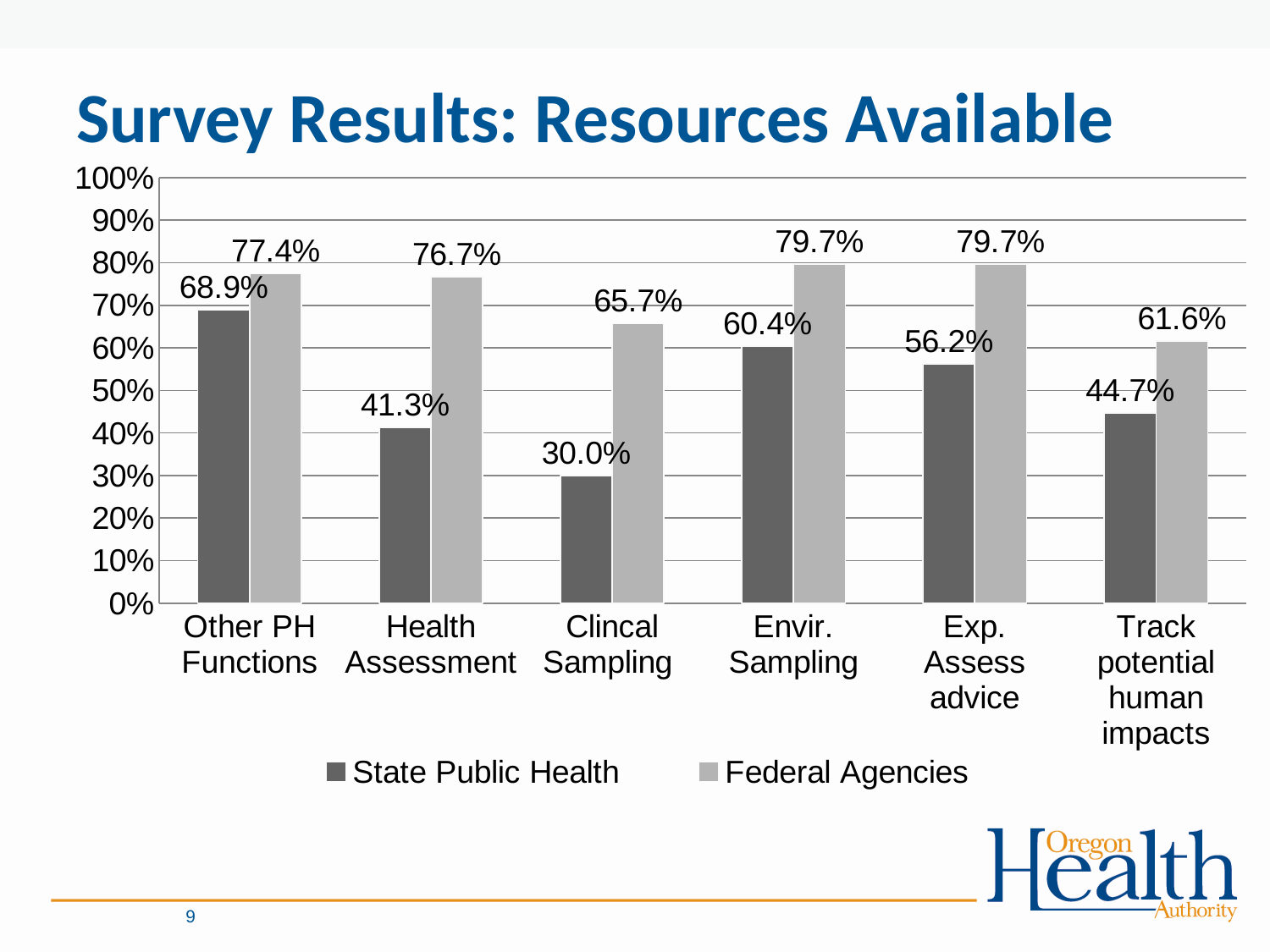
How many categories are shown on the x axis? 6 What is the State Public Health value for Clincal Sampling? 30.0% Which category has the lowest State Public Health value? Clincal Sampling What is the difference between the Federal Agencies and State Public Health values for Health Assessment? 35.4 percentage points For Envir. Sampling, which series has the larger value, State Public Health or Federal Agencies? Federal Agencies Which category has the lowest Federal Agencies value? Track potential human impacts Is the State Public Health value for Exp. Assess advice greater or less than 50%? greater Which category has the highest State Public Health value? Other PH Functions What type of chart is shown on the slide? Bar chart How many series does the legend list? 2 What is the Federal Agencies value for Track potential human impacts? 61.6% What is the Federal Agencies value for Health Assessment? 76.7%